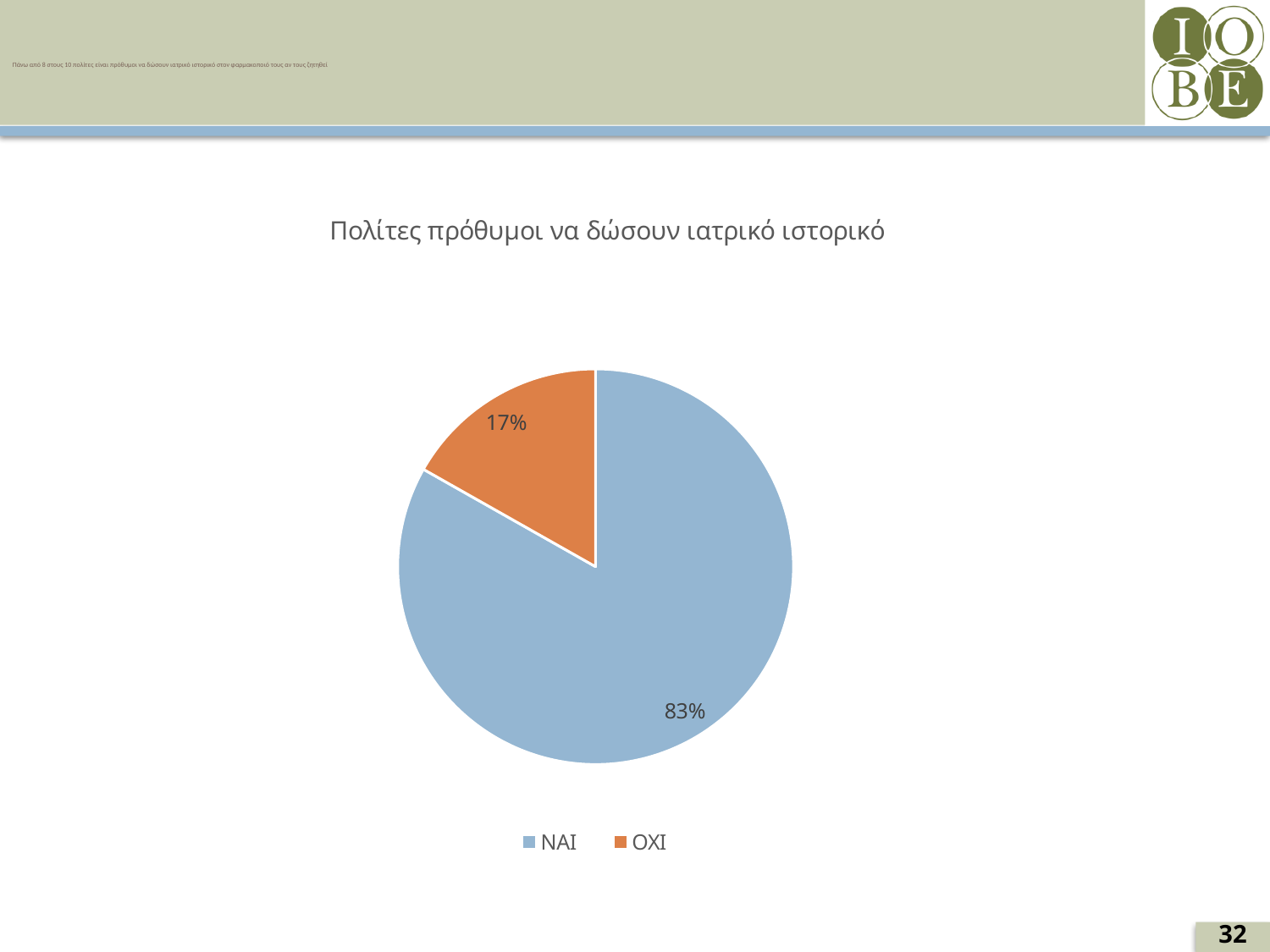
How many slices does the pie chart have? 2 Which is larger, the share for ΝΑΙ or the share for ΟΧΙ? ΝΑΙ What is the value for ΝΑΙ? 83% What is the difference between the ΝΑΙ and ΟΧΙ shares? 66% What kind of chart is shown on the slide? pie chart Which category has the largest share of the pie? ΝΑΙ What colour is the ΟΧΙ slice? orange Which category has the smallest share of the pie? ΟΧΙ How many entries does the legend list? 2 What share of the pie does the ΟΧΙ slice represent? 17% What is the value for ΟΧΙ? 17% What is the title of the chart? Πολίτες πρόθυμοι να δώσουν ιατρικό ιστορικό